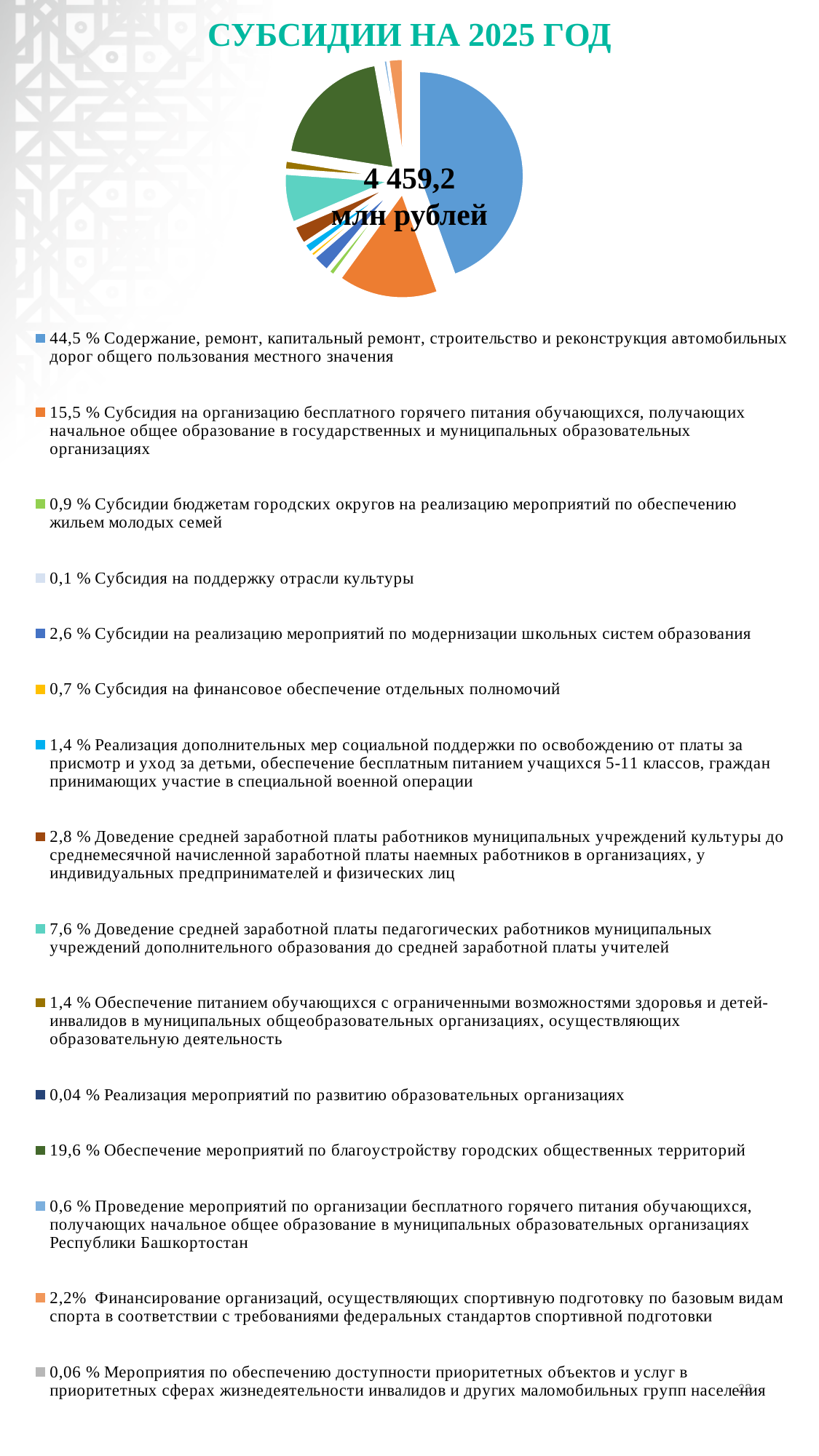
Which share is larger: 'Доведение средней заработной платы педагогических работников муниципальных учреждений дополнительного образования' or 'Субсидии на реализацию мероприятий по модернизации школьных систем образования'? Доведение средней заработной платы педагогических работников муниципальных учреждений дополнительного образования (7,6 %) Which category has the smallest share of the pie? Реализация мероприятий по развитию образовательных организациях (0,04 %) What share of the pie is 'Субсидия на поддержку отрасли культуры'? 0,1 % Which category has the largest share of the pie? Содержание, ремонт, капитальный ремонт, строительство и реконструкция автомобильных дорог общего пользования местного значения (44,5 %) How many categories does the legend of the pie chart list? 15 What is the title of the chart on the slide? СУБСИДИИ НА 2025 ГОД What share of the pie is 'Субсидия на организацию бесплатного горячего питания обучающихся, получающих начальное общее образование в государственных и муниципальных образовательных организациях'? 15,5 % What total value is printed in the centre of the pie chart? 4 459,2 млн рублей What share of the pie is 'Обеспечение мероприятий по благоустройству городских общественных территорий'? 19,6 % What is the difference in percentage points between the share for automobile roads (44,5 %) and the share for благоустройство городских общественных территорий (19,6 %)? 24,9 % What kind of chart is shown on the slide? Pie chart What share of the pie is 'Финансирование организаций, осуществляющих спортивную подготовку по базовым видам спорта'? 2,2%